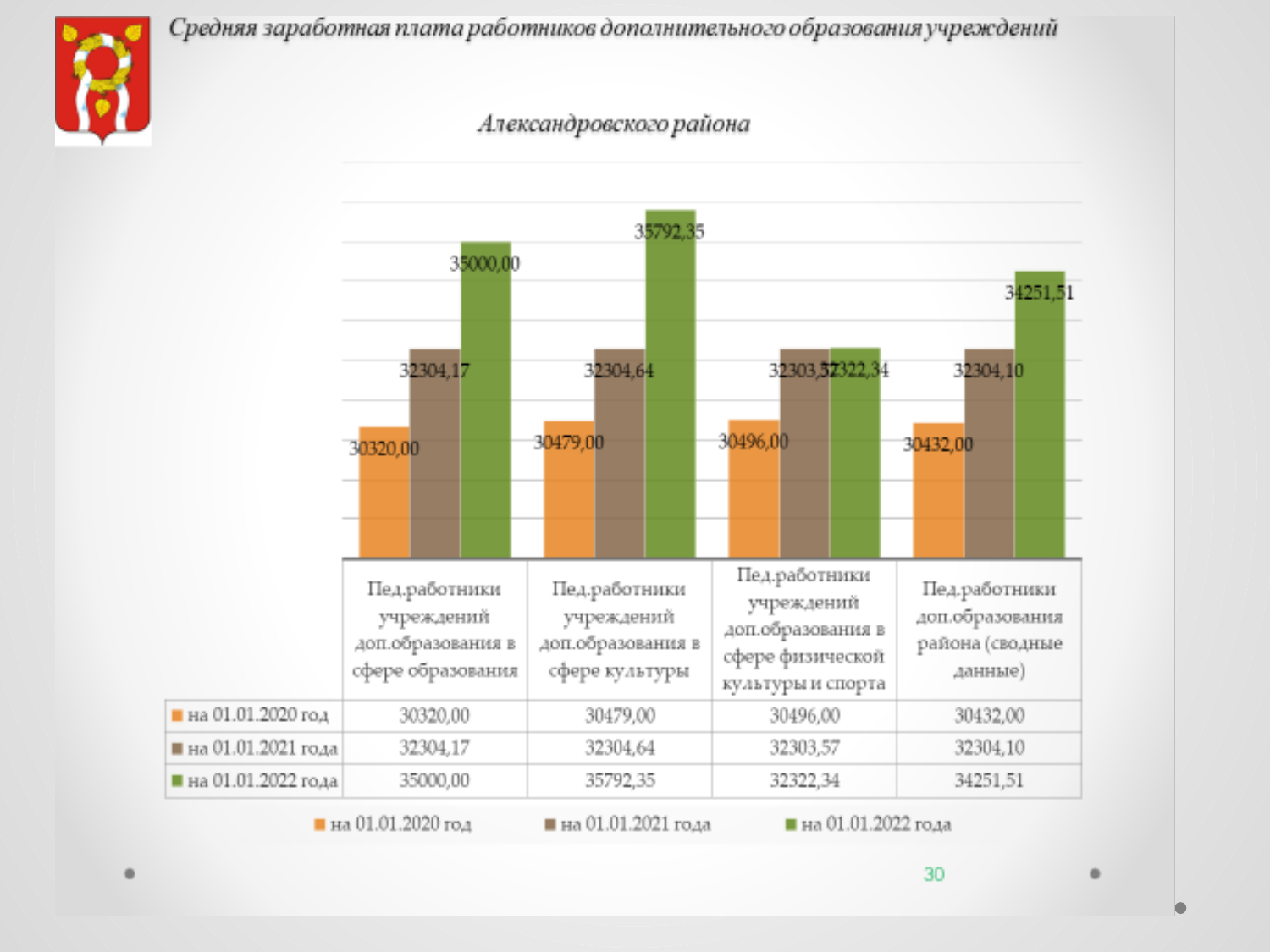
Which category has the highest value in the series 'на 01.01.2022 года'? Пед.работники учреждений доп.образования в сфере культуры How many series does the legend list? 3 What is the value for 'Пед.работники учреждений доп.образования в сфере образования' in the series 'на 01.01.2020 год'? 30320,00 What type of chart is shown on the slide? bar chart For 'Пед.работники учреждений доп.образования в сфере образования', do the values rise or fall from 01.01.2020 to 01.01.2022? rise What is the value for 'Пед.работники доп.образования района (сводные данные)' in the series 'на 01.01.2021 года'? 32304,10 For 'Пед.работники учреждений доп.образования в сфере образования', how much higher is the 'на 01.01.2022 года' value than the 'на 01.01.2020 год' value? 4680,00 Which category has the lowest value in the series 'на 01.01.2022 года'? Пед.работники учреждений доп.образования в сфере физической культуры и спорта What is the value for 'Пед.работники учреждений доп.образования в сфере культуры' in the series 'на 01.01.2022 года'? 35792,35 How many categories are shown on the x axis of the chart? 4 What is the difference between the 'на 01.01.2022 года' values for 'в сфере культуры' and 'в сфере образования'? 792,35 Which is larger: the 'на 01.01.2022 года' value for 'в сфере физической культуры и спорта' or for 'района (сводные данные)'? района (сводные данные)